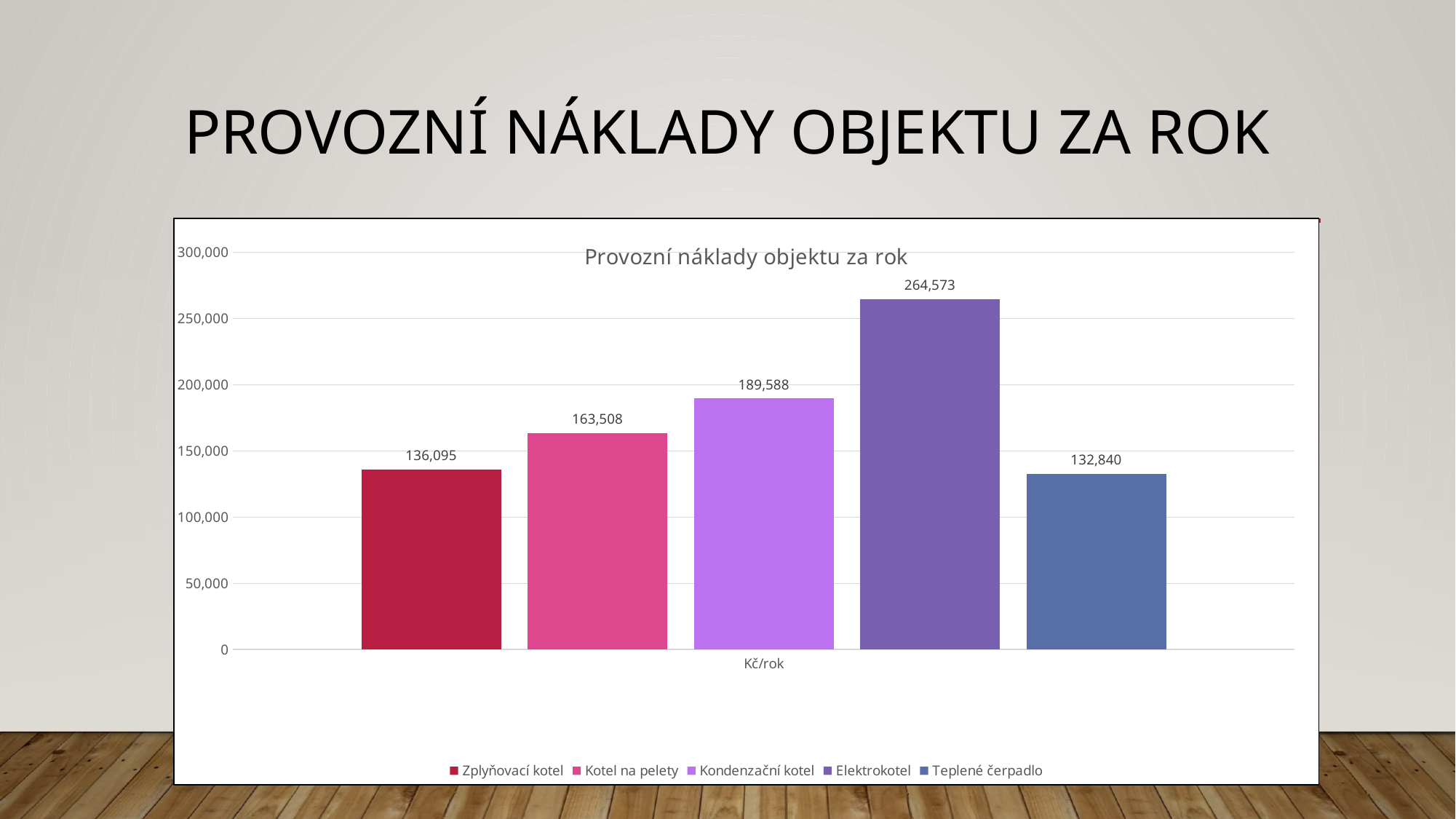
Which series has the highest value? Elektrokotel What is the value for Teplené čerpadlo? 132,840 What is the title of the chart? Provozní náklady objektu za rok What is the difference between the values for Kondenzační kotel and Kotel na pelety? 26,080 Which is larger, the value for Zplyňovací kotel or the value for Teplené čerpadlo? Zplyňovací kotel How many series does the legend list? 5 What is the value for Kotel na pelety? 163,508 What kind of chart is shown on the slide? bar chart What is the difference between the values for Elektrokotel and Teplené čerpadlo? 131,733 Which series has the lowest value? Teplené čerpadlo Is the value for Kondenzační kotel greater or less than 200,000? less What is the value for Elektrokotel? 264,573